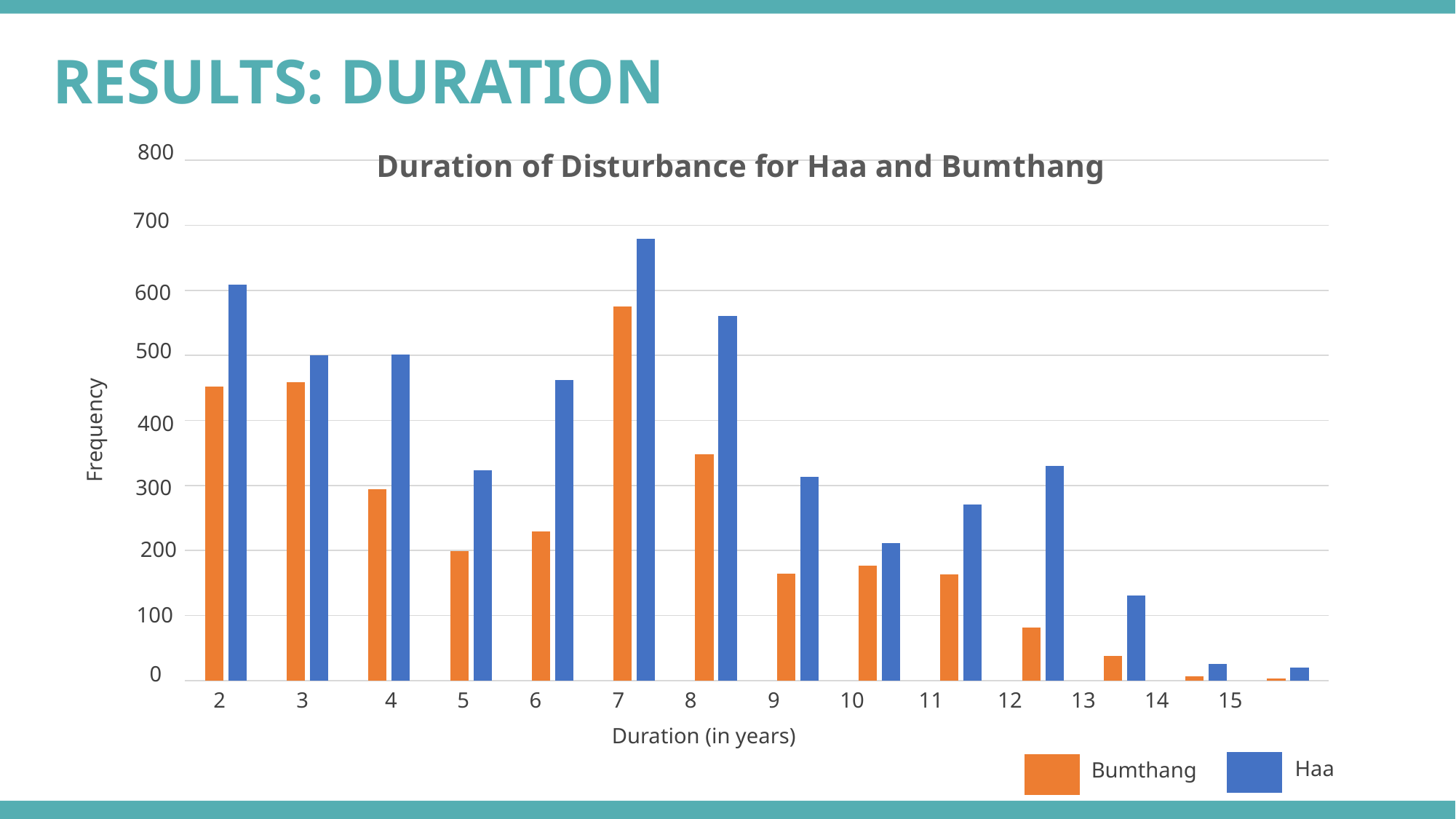
Is the Bumthang frequency for a duration of 7 years greater or less than 500? greater What kind of chart is shown on the slide? bar chart At which duration (in years) is the Bumthang frequency highest? 7 Is the Haa frequency for a duration of 6 years greater or less than 500? less What is the title of the chart? Duration of Disturbance for Haa and Bumthang Is the Bumthang frequency for a duration of 12 years greater or less than 100? less How many series does the legend list? 2 For a duration of 12 years, which series has the higher frequency, Bumthang or Haa? Haa At which duration (in years) is the Haa frequency highest? 7 For Haa, which duration has the higher frequency, 11 years or 12 years? 12 years Which two series are shown in the legend? Bumthang and Haa